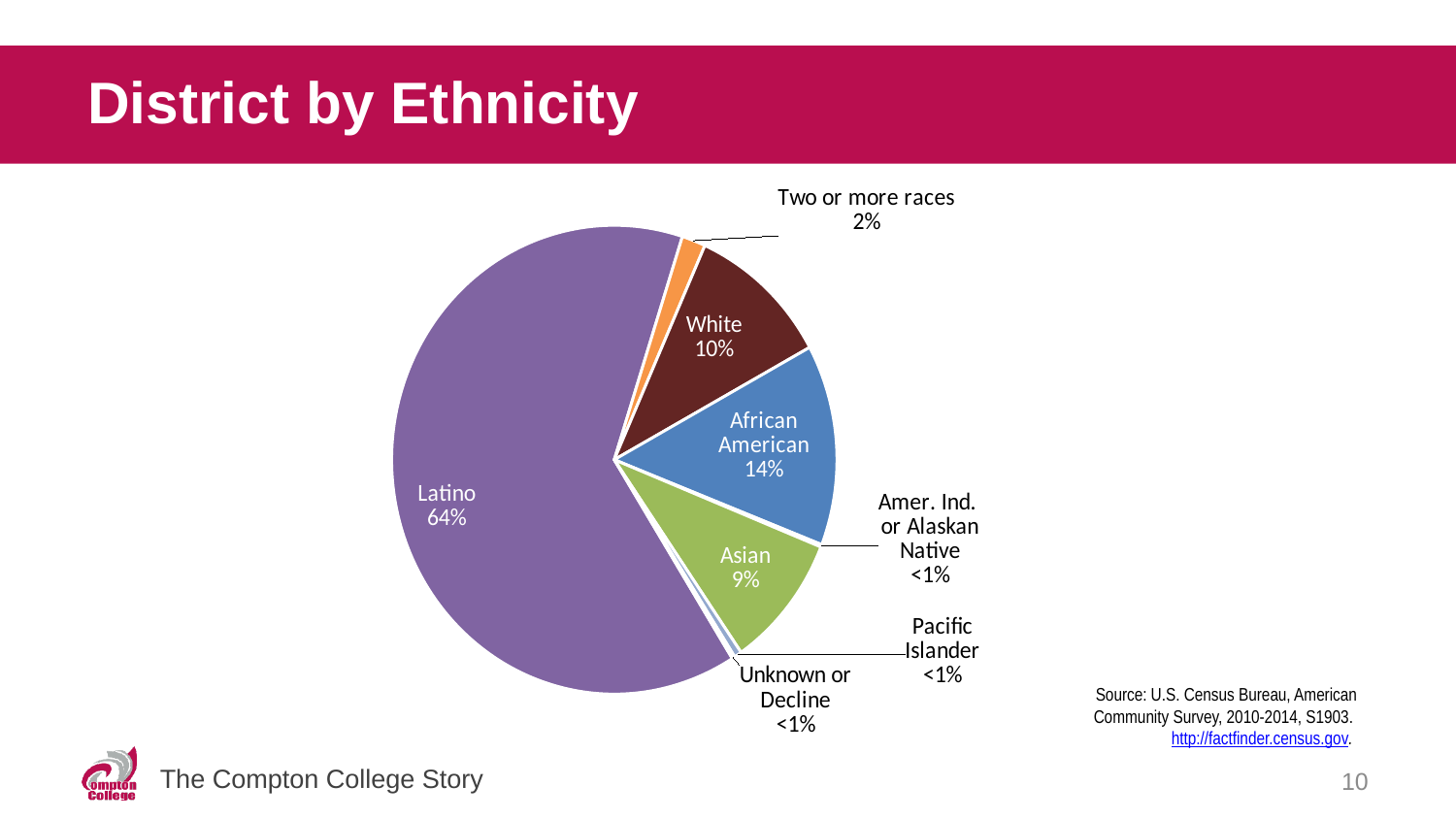
What percentage of the district is Two or more races? 2% How many ethnicity categories are shown in the pie chart? 8 What percentage of the district is Asian? 9% What is the title of the chart slide? District by Ethnicity Which is larger, the White share or the Asian share? White What percentage of the district is White? 10% What value is shown for Pacific Islander? <1% What percentage of the district is African American? 14% What is the difference in percentage points between the Latino and African American shares? 50 percentage points What share of the district is Latino? 64% Which ethnicity has the largest share of the district? Latino What kind of chart is shown on the slide? Pie chart